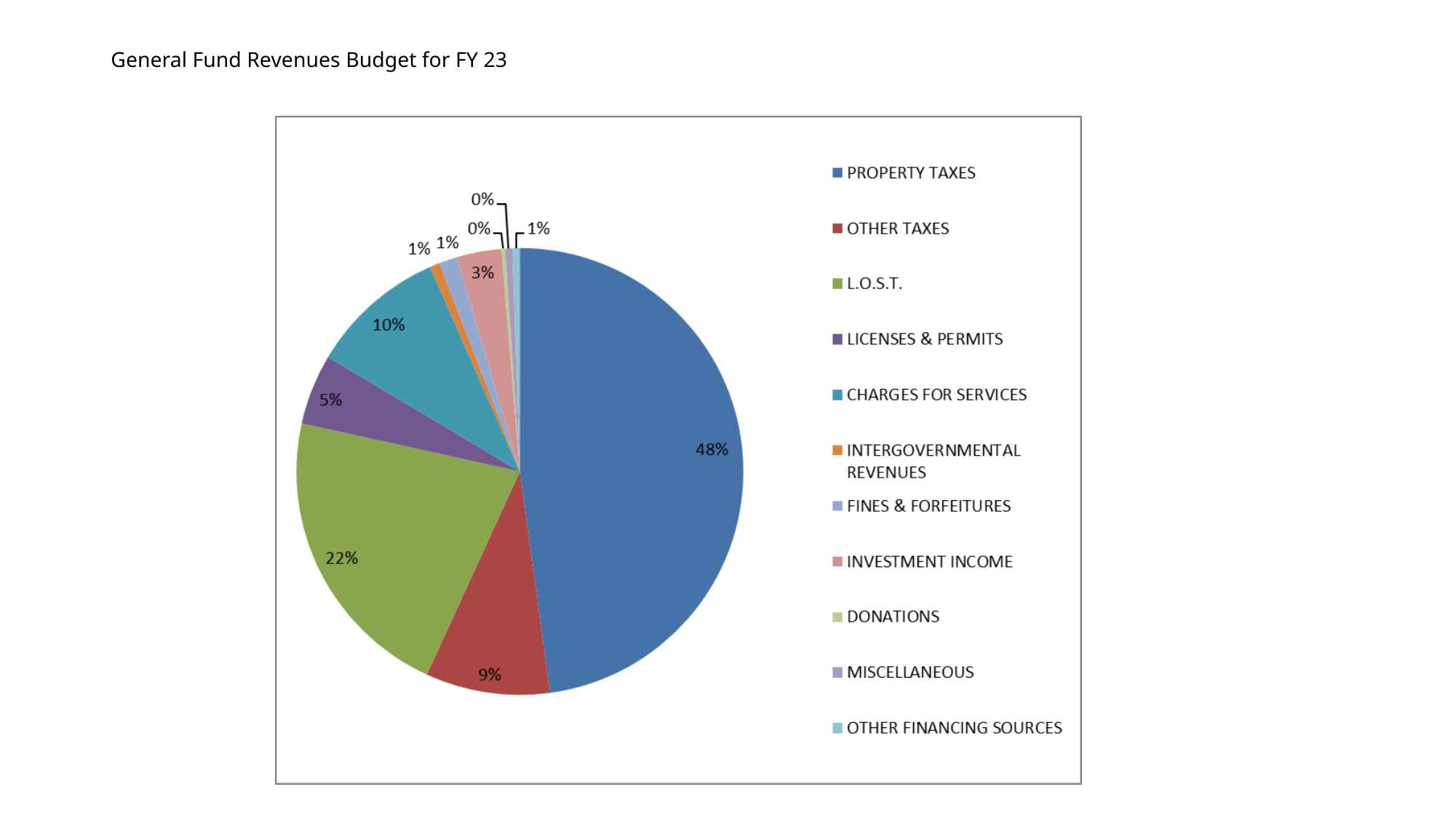
How many categories does the legend list? 11 What share of the pie does L.O.S.T. represent? 22% What is the value shown for INVESTMENT INCOME? 3% What is the difference between the PROPERTY TAXES share and the L.O.S.T. share? 26% What is the title of the slide? General Fund Revenues Budget for FY 23 What type of chart is shown on the slide? pie chart What share of the pie does PROPERTY TAXES represent? 48% Which category has the largest slice of the pie? PROPERTY TAXES What is the value shown for CHARGES FOR SERVICES? 10% Which is larger, L.O.S.T. or CHARGES FOR SERVICES? L.O.S.T. What is the value shown for OTHER TAXES? 9% What is the value shown for LICENSES & PERMITS? 5%